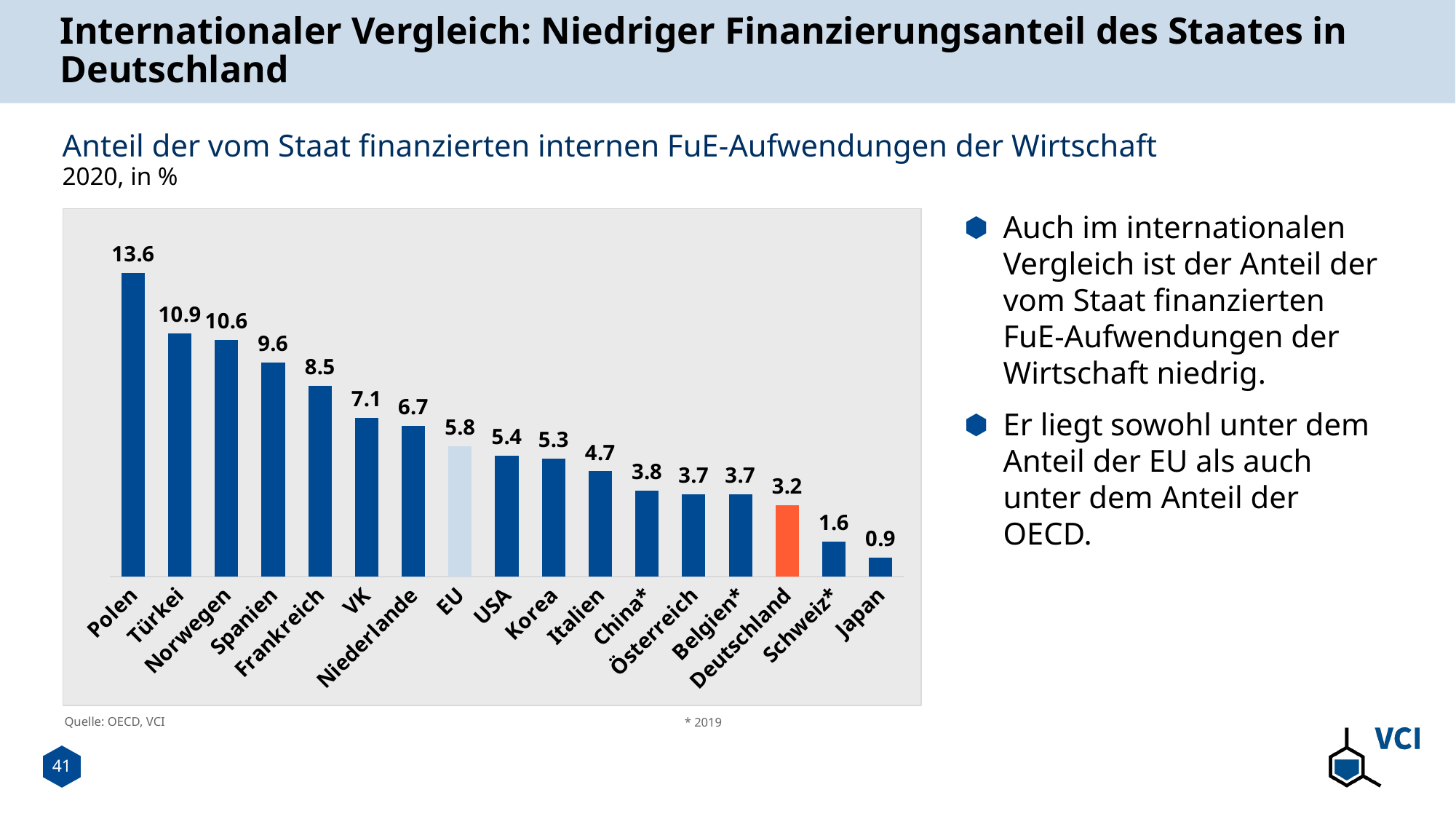
What kind of chart is shown on the slide? Bar chart What is the difference between the values for EU and Deutschland? 2.6 Which bar is highlighted in orange? Deutschland Do the values rise or fall from left to right along the x axis? Fall What is the value for Deutschland? 3.2 Which category has the highest value? Polen Which category has the lowest value? Japan Which is larger, the value for Norwegen or the value for Spanien? Norwegen What is the value for EU? 5.8 What is the value for Frankreich? 8.5 How many categories are shown on the x axis? 17 What is the difference between the values for Polen and Japan? 12.7